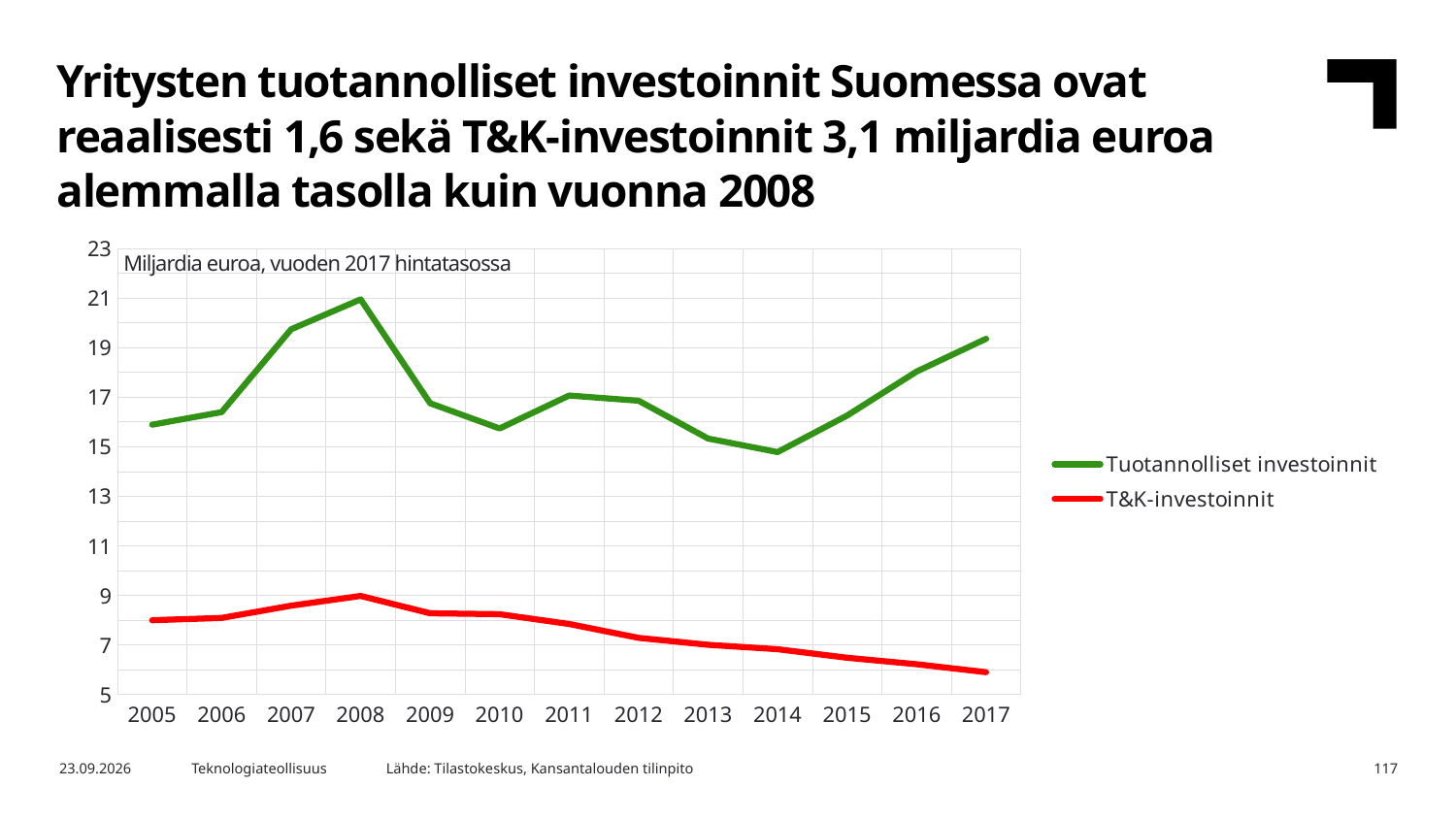
What kind of chart is shown on the slide? line chart In which year is the value for Tuotannolliset investoinnit highest? 2008 In which year is the value for T&K-investoinnit lowest? 2017 Which series has the larger value in 2017, Tuotannolliset investoinnit or T&K-investoinnit? Tuotannolliset investoinnit What colour is the line for T&K-investoinnit? red Is the value for Tuotannolliset investoinnit in 2008 greater or less than 19? greater Do the values for T&K-investoinnit rise or fall from 2008 to 2017? fall Is the value for T&K-investoinnit in 2017 greater or less than 7? less In which year is the value for Tuotannolliset investoinnit lowest? 2014 How many series does the legend list? 2 How many years are shown on the x axis? 13 Is the value for Tuotannolliset investoinnit in 2014 greater or less than 17? less